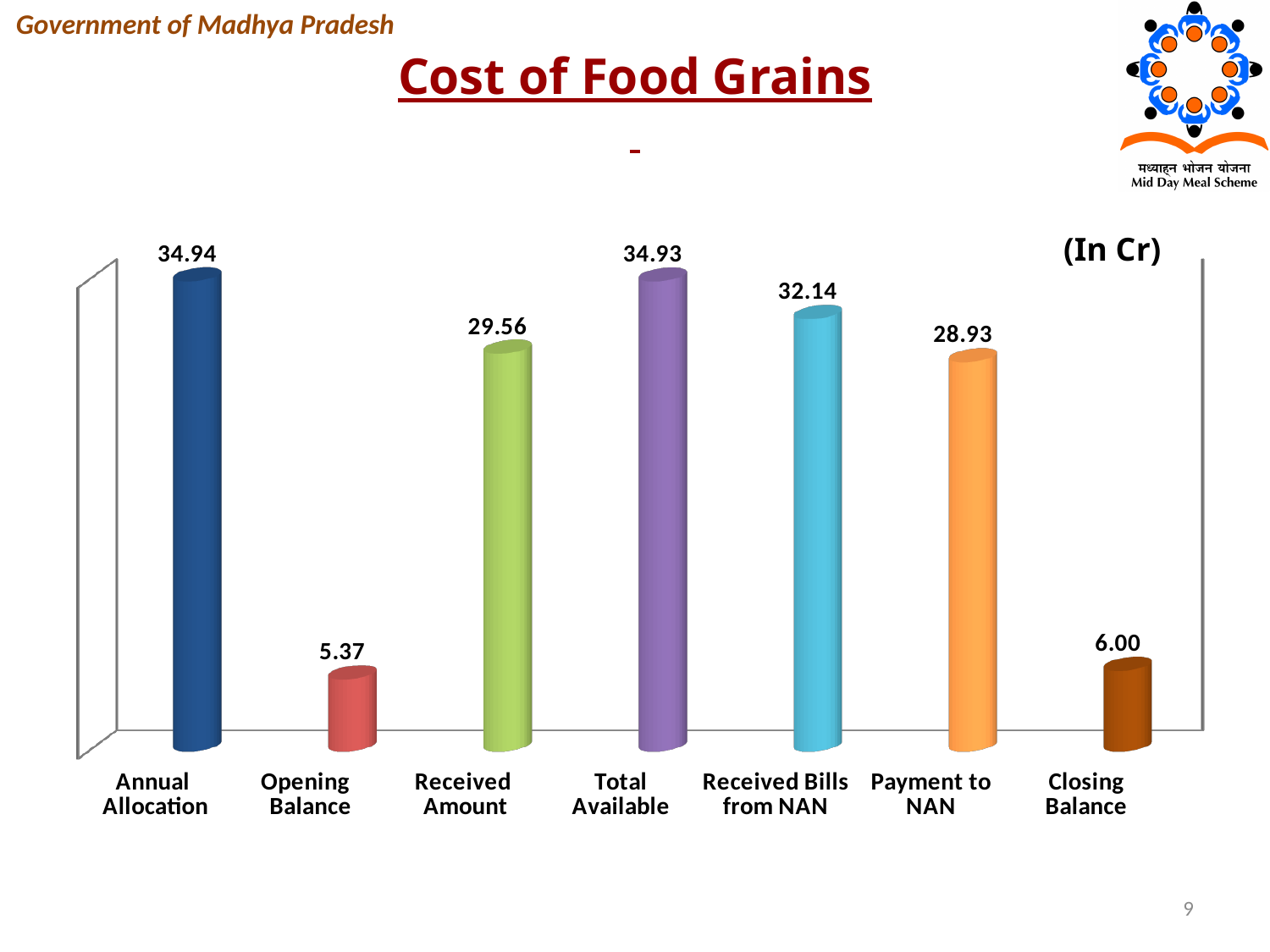
What is the difference between Received Bills from NAN and Payment to NAN? 3.21 In what unit are the chart values expressed? In Cr How many categories are shown in the chart? 7 What is the value for Received Bills from NAN? 32.14 What is the value for Annual Allocation? 34.94 What kind of chart is shown on the slide? Bar chart What is the difference between Annual Allocation and Opening Balance? 29.57 Which is larger, Received Amount or Payment to NAN? Received Amount What is the value for Closing Balance? 6.00 Which category has the lowest value? Opening Balance What is the value for Payment to NAN? 28.93 What is the value for Opening Balance? 5.37